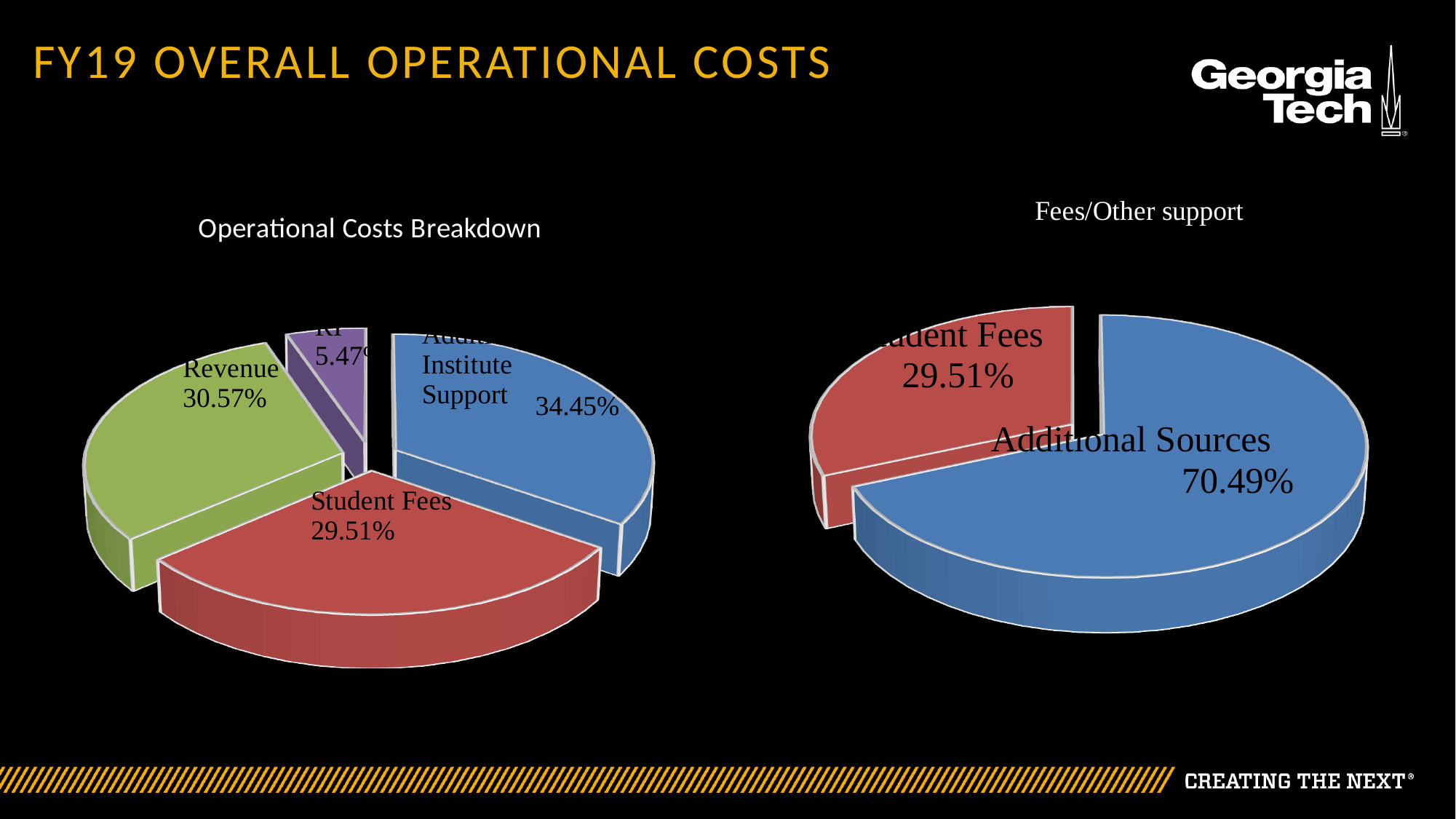
In the Operational Costs Breakdown chart, which slice is larger: Revenue or Student Fees? Revenue In the Operational Costs Breakdown chart, what percentage is shown for Revenue? 30.57% In the Operational Costs Breakdown chart, what percentage is shown for Student Fees? 29.51% How many slices does the Operational Costs Breakdown chart have? 4 How many slices does the Fees/Other support chart have? 2 In the Operational Costs Breakdown chart, what is the difference between the Revenue and Student Fees percentages? 1.06% In the Fees/Other support chart, what is the difference between the Additional Sources and Student Fees percentages? 40.98% In the Operational Costs Breakdown chart, what is the smallest percentage shown on any slice? 5.47% What type of chart is the Fees/Other support chart? Pie chart In the Fees/Other support chart, what percentage is shown for Additional Sources? 70.49% In the Fees/Other support chart, what percentage is shown for Student Fees? 29.51% In the Operational Costs Breakdown chart, what percentage is shown for the Institute Support slice? 34.45%